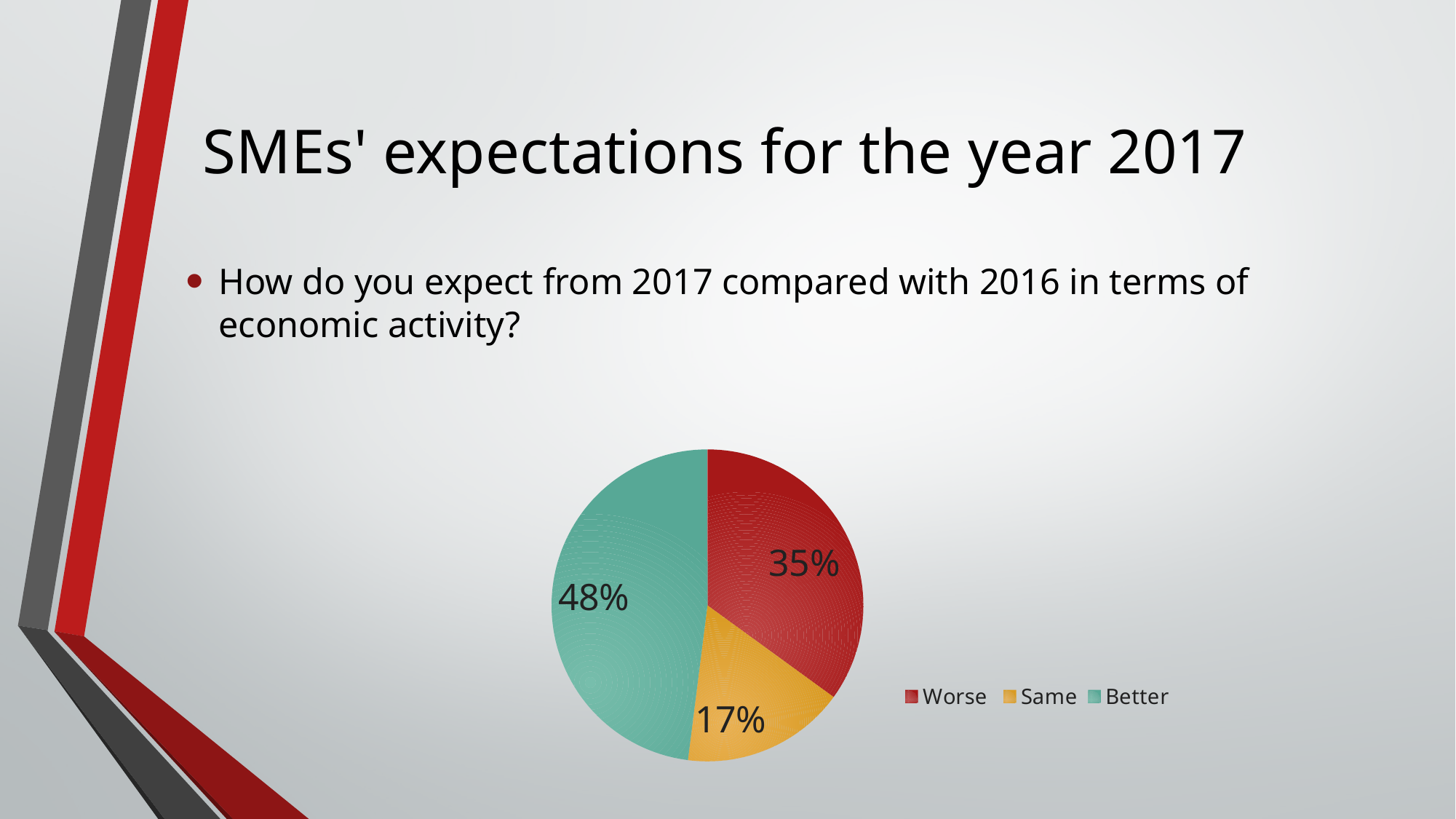
What kind of chart is shown on the slide? pie chart How many categories does the pie chart show? 3 What share of SMEs expect 2017 to be worse than 2016? 35% What share of SMEs expect 2017 to be the same as 2016? 17% What share of SMEs expect 2017 to be better than 2016? 48% What are the three legend entries of the pie chart? Worse, Same, Better Which response has the smallest slice of the pie? Same Which response has the largest slice of the pie? Better What colour is the Better slice in the pie chart? teal (green) What is the difference in percentage points between the Worse and Same slices? 18 Which slice is larger, Worse or Same? Worse What is the difference in percentage points between the Better and Worse slices? 13